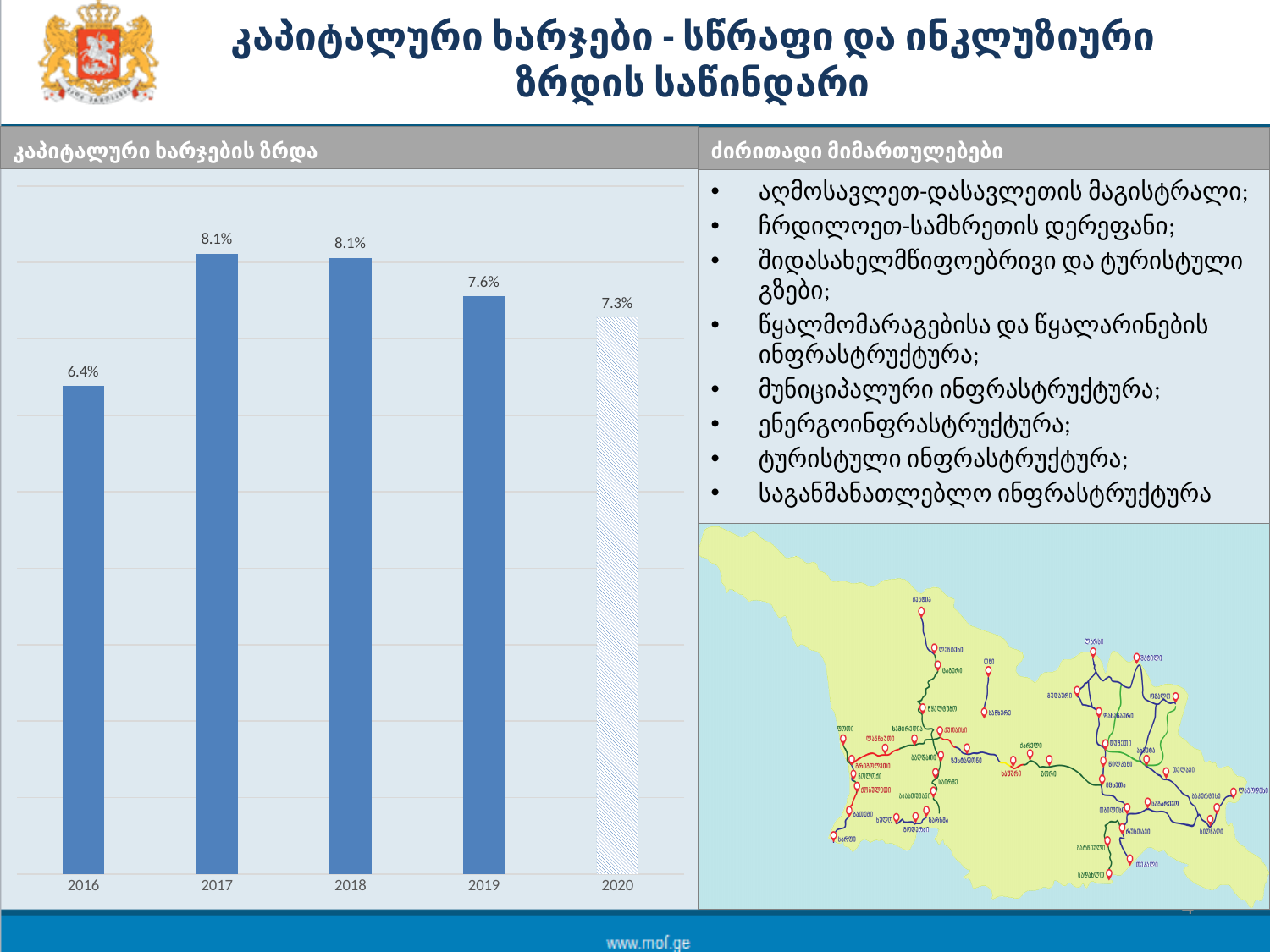
What is the value for 2020 in the bar chart? 7.3% What is the difference between the values for 2017 and 2016? 1.7 percentage points Do the values rise or fall from 2018 to 2020? Fall What kind of chart is shown on the slide? Bar chart How many years are shown on the x axis of the bar chart? 5 What is the value for 2017 in the bar chart? 8.1% What is the difference between the values for 2019 and 2020? 0.3 percentage points What is the value for 2016 in the bar chart? 6.4% Which is larger, the value for 2018 or the value for 2020? 2018 Which year has the lowest value in the bar chart? 2016 What is the value for 2019 in the bar chart? 7.6% Which year's bar is drawn with a hatched pattern instead of solid fill? 2020